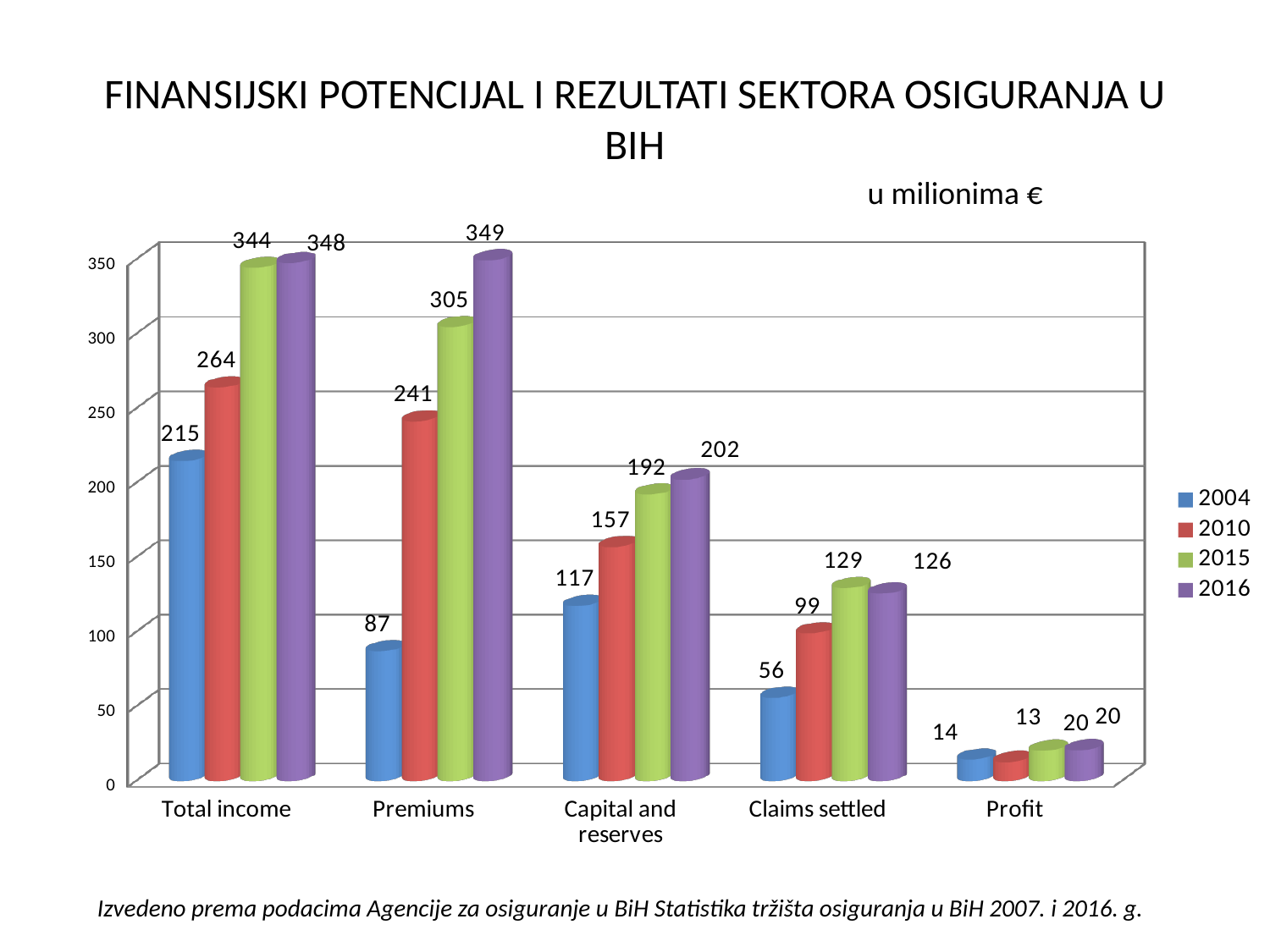
How many series does the legend list? 4 What is the value for Total income in 2004? 215 How many categories are shown on the x axis? 5 What kind of chart is shown on the slide? Bar chart Which year has the highest value for Premiums? 2016 What is the value for Capital and reserves in 2010? 157 Which category has the lowest value in 2016? Profit Which is larger, Claims settled in 2015 or Claims settled in 2016? Claims settled in 2015 What is the value for Claims settled in 2015? 129 What is the difference between the 2016 and 2004 values for Premiums? 262 What unit is stated above the chart? u milionima € What is the value for Premiums in 2016? 349